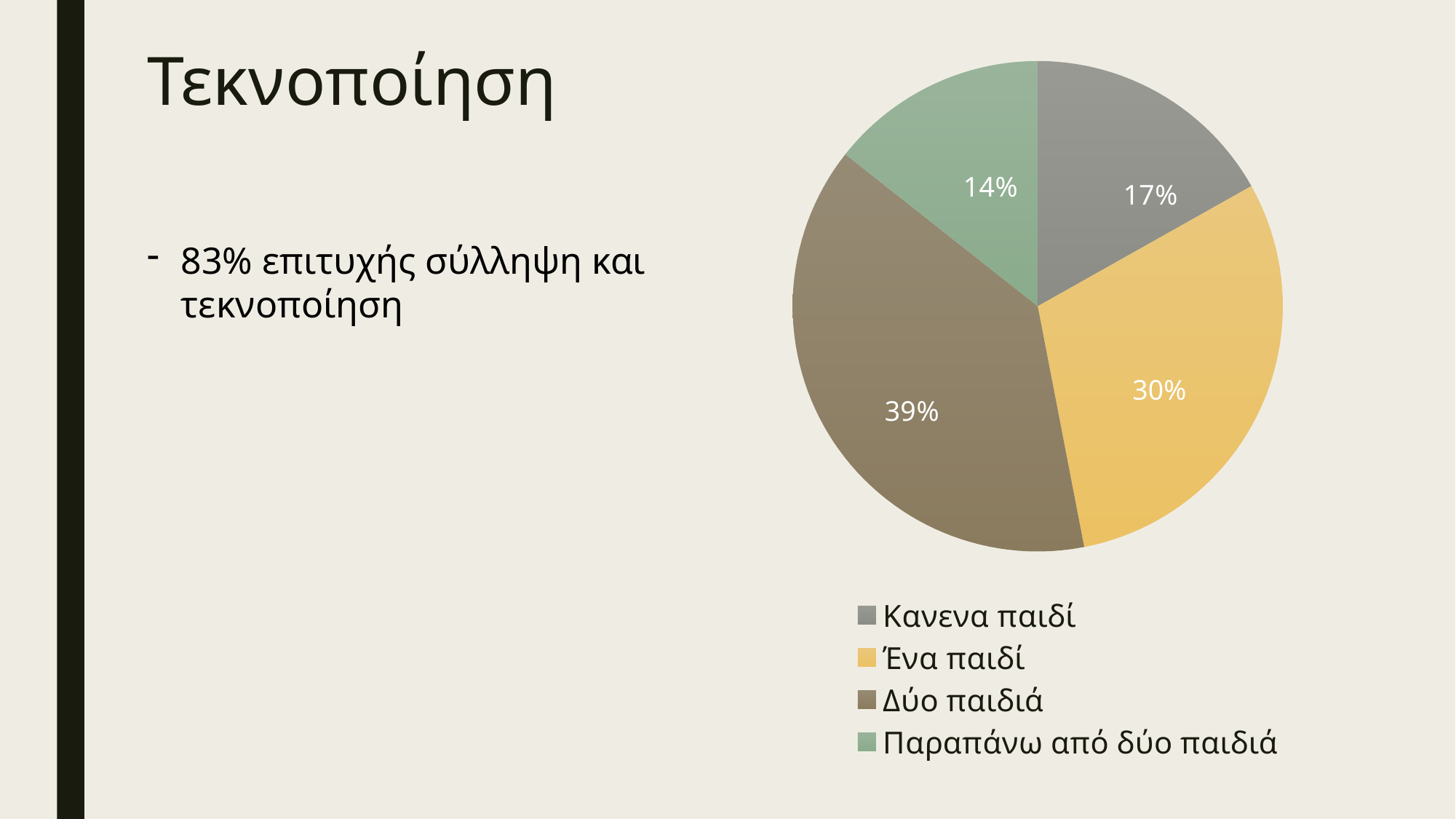
Which slice is larger: 'Κανενα παιδί' or 'Παραπάνω από δύο παιδιά'? Κανενα παιδί Which category has the largest slice of the pie? Δύο παιδιά What percentage of the pie is labelled 'Δύο παιδιά'? 39% What percentage of the pie is labelled 'Ένα παιδί'? 30% Which category has the smallest slice of the pie? Παραπάνω από δύο παιδιά How many categories does the pie chart have? 4 What is the combined share of the 'Κανενα παιδί' and 'Ένα παιδί' slices? 47% What percentage of the pie is labelled 'Κανενα παιδί'? 17% What percentage of the pie is labelled 'Παραπάνω από δύο παιδιά'? 14% What is the difference in percentage points between the 'Δύο παιδιά' slice and the 'Ένα παιδί' slice? 9 What colour is the slice for 'Ένα παιδί'? yellow What type of chart is shown on the slide? pie chart